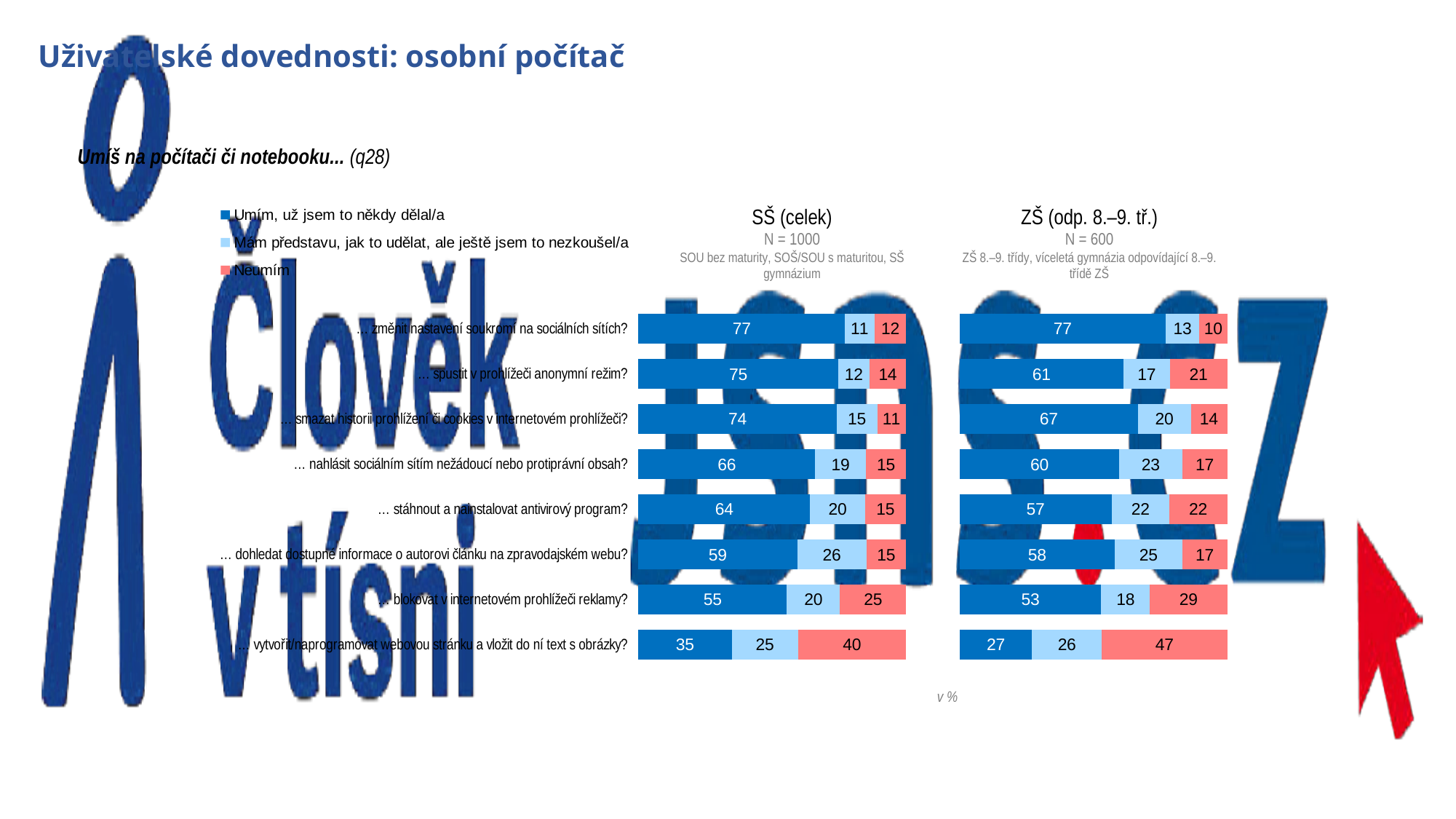
In the SŠ (celek) chart, what percentage answered "Umím, už jsem to někdy dělal/a" for "… spustit v prohlížeči anonymní režim?"? 75 In the ZŠ (odp. 8.–9. tř.) chart, what is the total of the three segments for "… blokovat v internetovém prohlížeči reklamy?"? 100 In the ZŠ (odp. 8.–9. tř.) chart, what is the "Mám představu, jak to udělat, ale ještě jsem to nezkoušel/a" value for "… nahlásit sociálním sítím nežádoucí nebo protiprávní obsah?"? 23 What type of chart is used for the ZŠ (odp. 8.–9. tř.) data? Stacked bar chart In the ZŠ (odp. 8.–9. tř.) chart, what is the "Neumím" value for "… vytvořit/naprogramovat webovou stránku a vložit do ní text s obrázky?"? 47 In the SŠ (celek) chart, is the "Neumím" value larger for "… blokovat v internetovém prohlížeči reklamy?" or for "… stáhnout a nainstalovat antivirový program?"? … blokovat v internetovém prohlížeči reklamy? What sample size (N) is given for the SŠ (celek) chart? N = 1000 How many items (categories) are shown in the SŠ (celek) chart? 8 What is the difference between the SŠ (celek) and ZŠ (odp. 8.–9. tř.) "Umím, už jsem to někdy dělal/a" values for "… spustit v prohlížeči anonymní režim?"? 14 How many series does the legend list? 3 In the SŠ (celek) chart, which item has the lowest "Umím, už jsem to někdy dělal/a" value? … vytvořit/naprogramovat webovou stránku a vložit do ní text s obrázky? In the ZŠ (odp. 8.–9. tř.) chart, which item has the highest "Umím, už jsem to někdy dělal/a" value? … změnit nastavení soukromí na sociálních sítích?